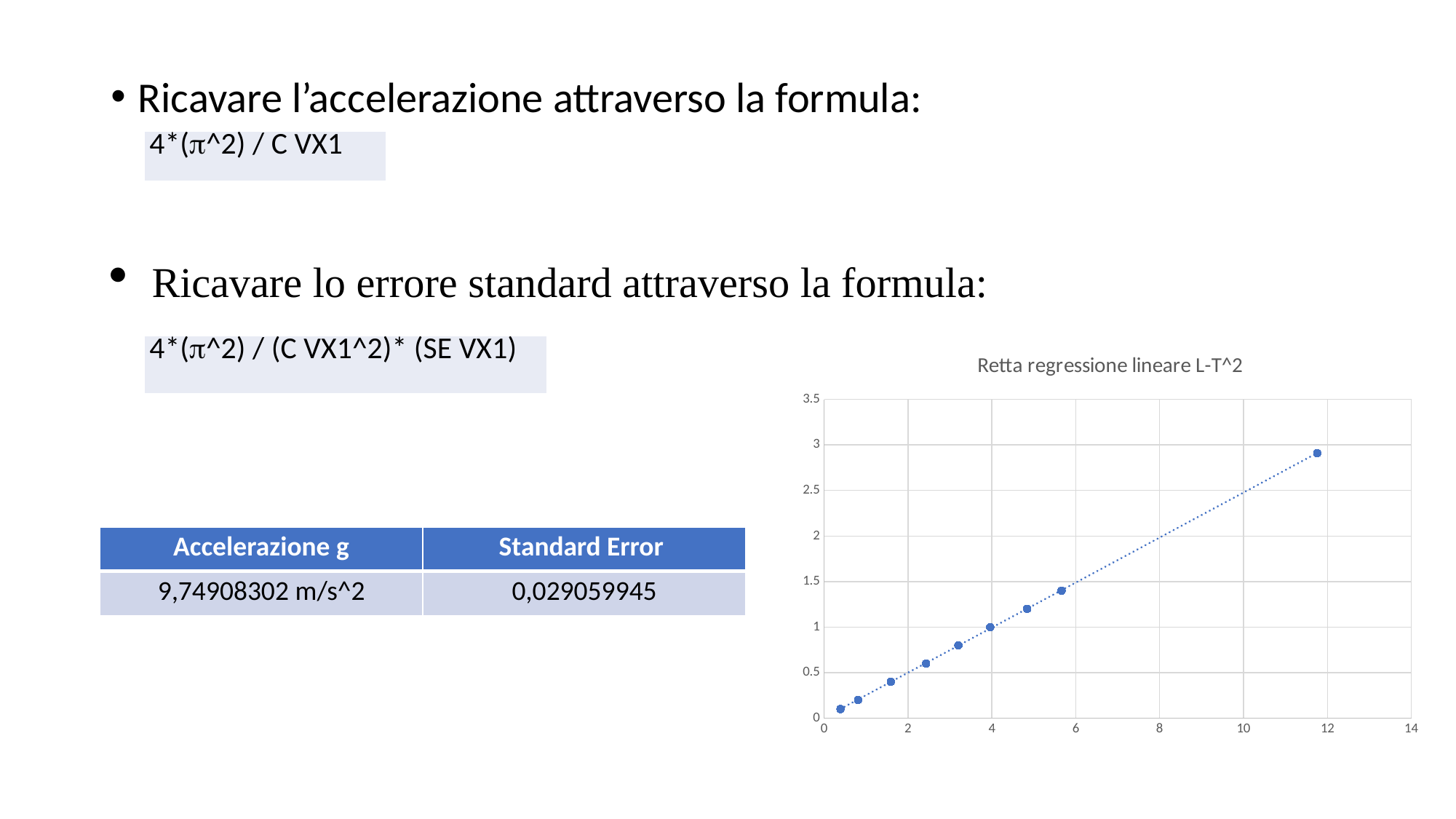
Is the y value of the point with the largest x value greater or less than 2? greater What kind of chart is shown on the slide? scatter chart What is the title of the chart on the slide? Retta regressione lineare L-T^2 How many data points are plotted in the chart? 9 Is the x value of the rightmost point in the chart greater or less than 10? greater Is the y value of the rightmost point in the chart greater or less than 2.5? greater Do the plotted values rise or fall as the x value increases? rise How many data points have an x value below 6? 8 What is the maximum value shown on the y axis of the chart? 3.5